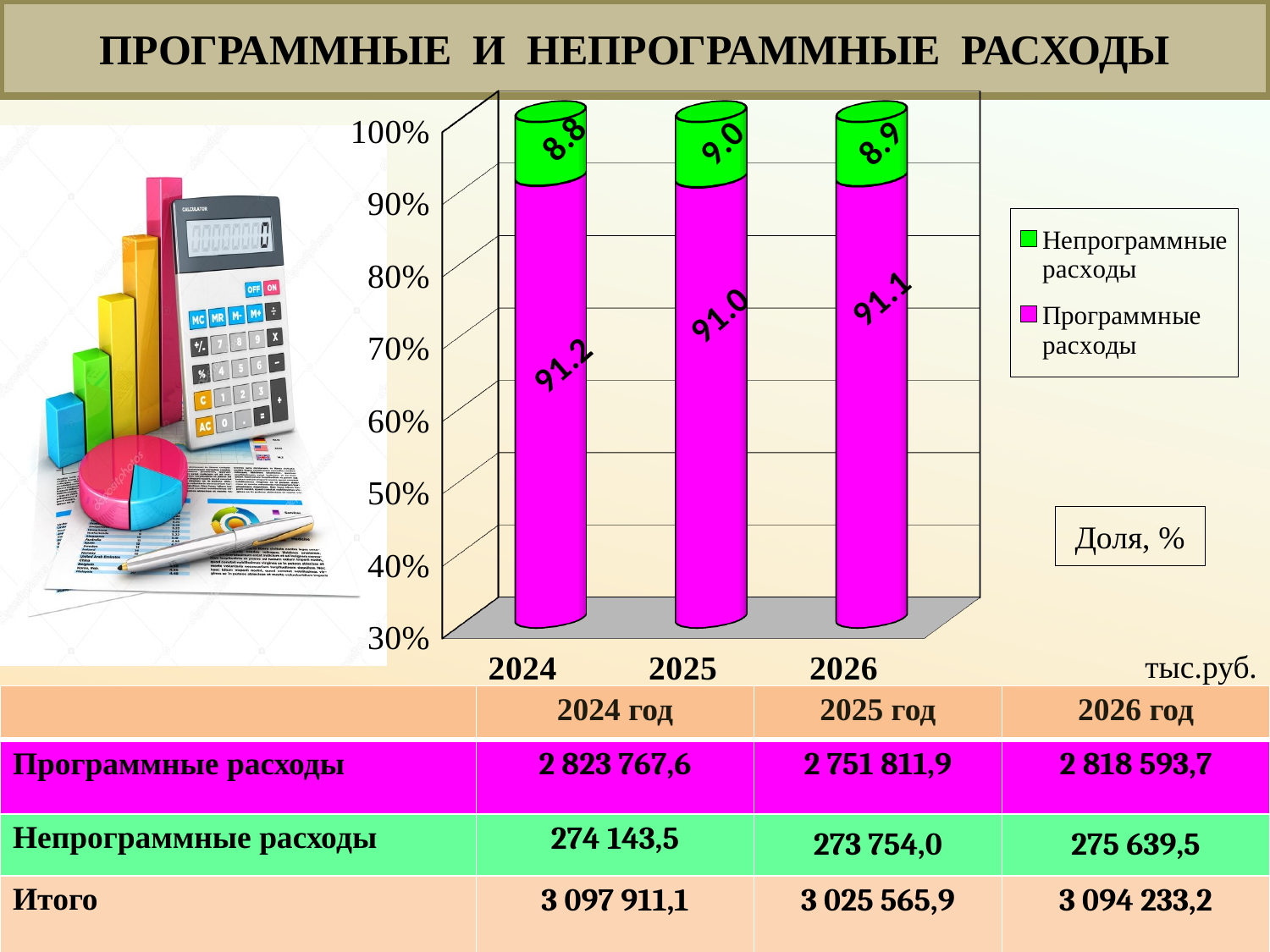
Which colour represents Программные расходы in the chart? Magenta In which year is the share of Непрограммные расходы highest? 2025 What kind of chart is shown on the slide? Stacked bar chart What is the share of Непрограммные расходы in 2025? 9.0 What is the share of Непрограммные расходы in 2026? 8.9 What is the share of Программные расходы in 2026? 91.1 What is the share of Программные расходы in 2024? 91.2 How many years are shown on the x axis of the chart? 3 How many series does the chart legend list? 2 In which year is the share of Программные расходы lowest? 2025 Which is larger: the share of Непрограммные расходы in 2024 or in 2026? 2026 What is the difference between the share of Программные расходы in 2024 and in 2025? 0.2